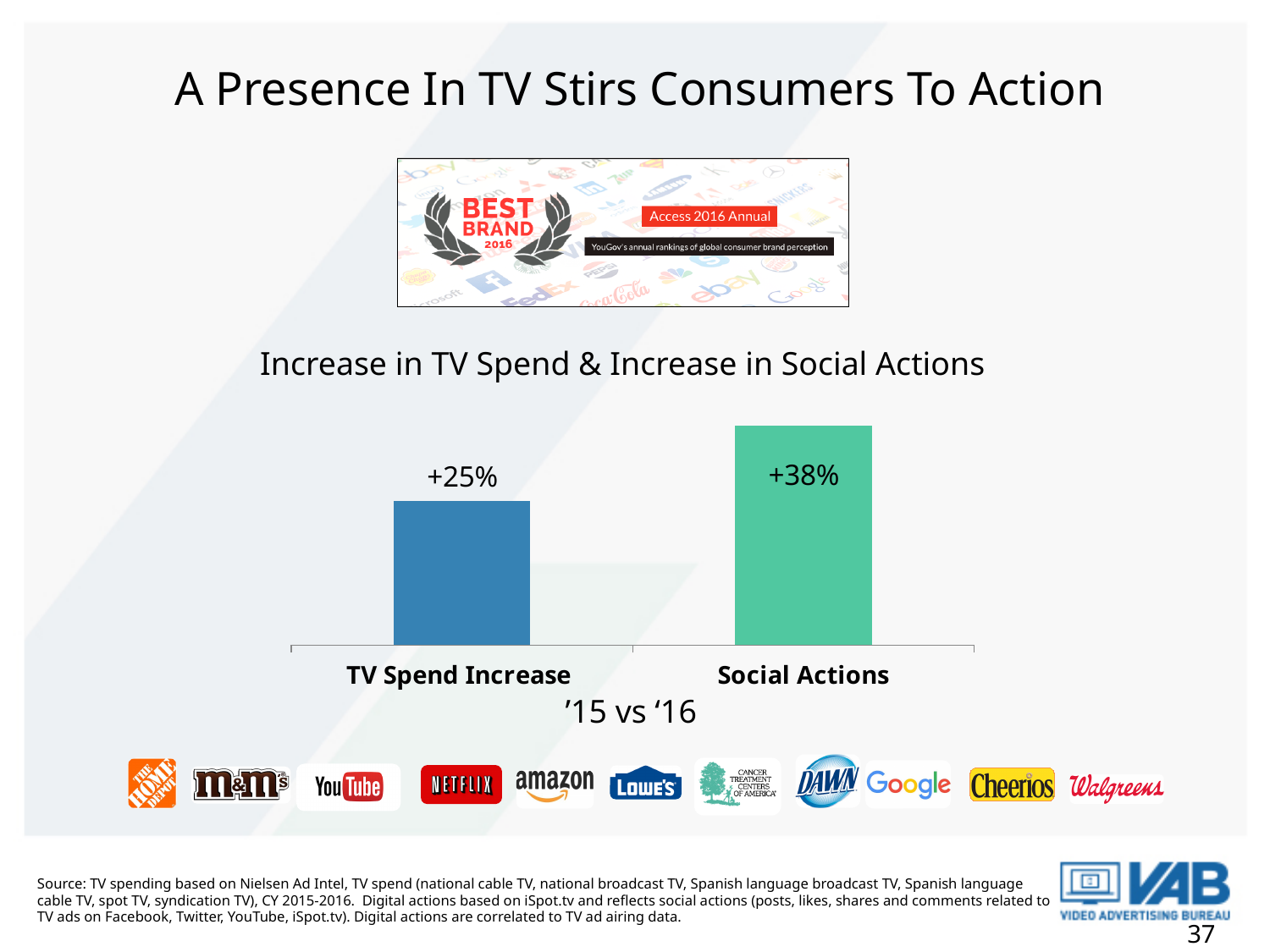
Which category has the lower value? TV Spend Increase What is the title of the chart? Increase in TV Spend & Increase in Social Actions Which category has the higher value, TV Spend Increase or Social Actions? Social Actions How many categories are plotted in the chart? 2 What period comparison is labelled beneath the chart's x axis? '15 vs '16 Do the values rise or fall moving from TV Spend Increase to Social Actions along the x axis? rise What is the difference in percentage points between Social Actions and TV Spend Increase? 13 percentage points What is the value shown for TV Spend Increase? +25% What kind of chart is shown on the slide? bar chart What is the value shown for Social Actions? +38% Is the value for Social Actions larger or smaller than the value for TV Spend Increase? larger